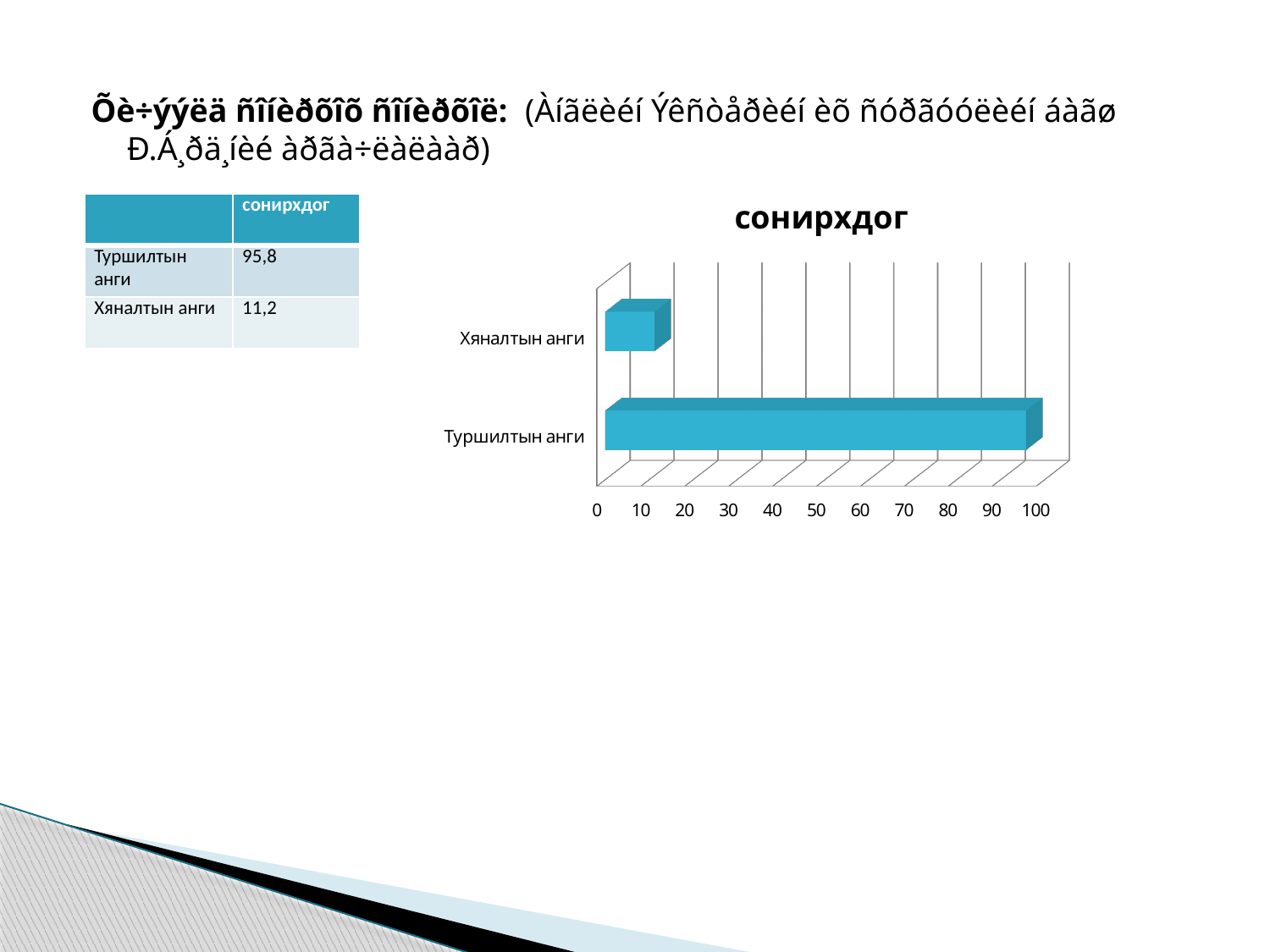
Is the value for Хяналтын анги greater or less than 20? less According to the table on the slide, what is the сонирхдог value for Хяналтын анги? 11,2 Which category has the highest value in the chart? Туршилтын анги Using the values in the table, what is the difference between Туршилтын анги and Хяналтын анги? 84,6 What is the maximum value shown on the chart's horizontal axis? 100 What kind of chart is shown on the slide? bar chart According to the table on the slide, what is the сонирхдог value for Туршилтын анги? 95,8 How many categories does the chart show? 2 Is the value for Туршилтын анги greater or less than 90? greater Which is larger, the value for Туршилтын анги or the value for Хяналтын анги? Туршилтын анги Which category has the lowest value in the chart? Хяналтын анги What is the title of the chart? сонирхдог